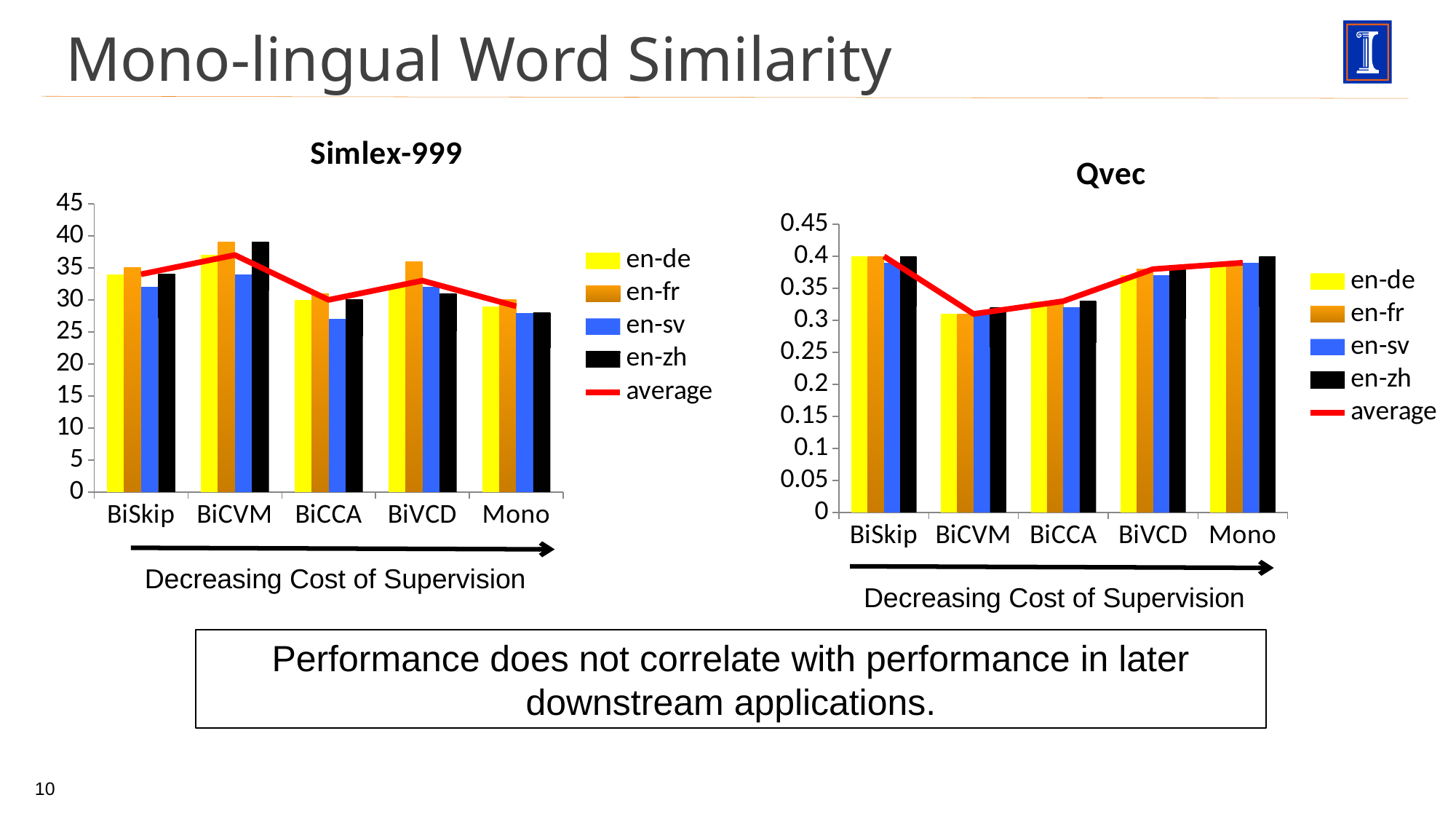
What label is written under the arrow beneath the x axis of the Simlex-999 chart? Decreasing Cost of Supervision How many entries does the legend of the Qvec chart list? 5 In the Qvec chart, is the en-de value for BiCVM greater or less than 0.35? less In the Qvec chart, does the average line rise or fall from BiCVM to BiVCD? rise How many categories are shown on the x axis of the Simlex-999 chart? 5 In the Simlex-999 chart, is the en-sv value for BiCCA greater or less than 30? less What kind of chart is the Simlex-999 chart? bar chart with a line In the Simlex-999 chart, is the en-zh value for BiCVM greater or less than 35? greater In the Simlex-999 chart, which is larger for BiVCD: the en-fr bar or the en-zh bar? en-fr In the Qvec chart, at which category is the average line lowest? BiCVM In the Simlex-999 chart, which category has the highest en-fr bar? BiCVM